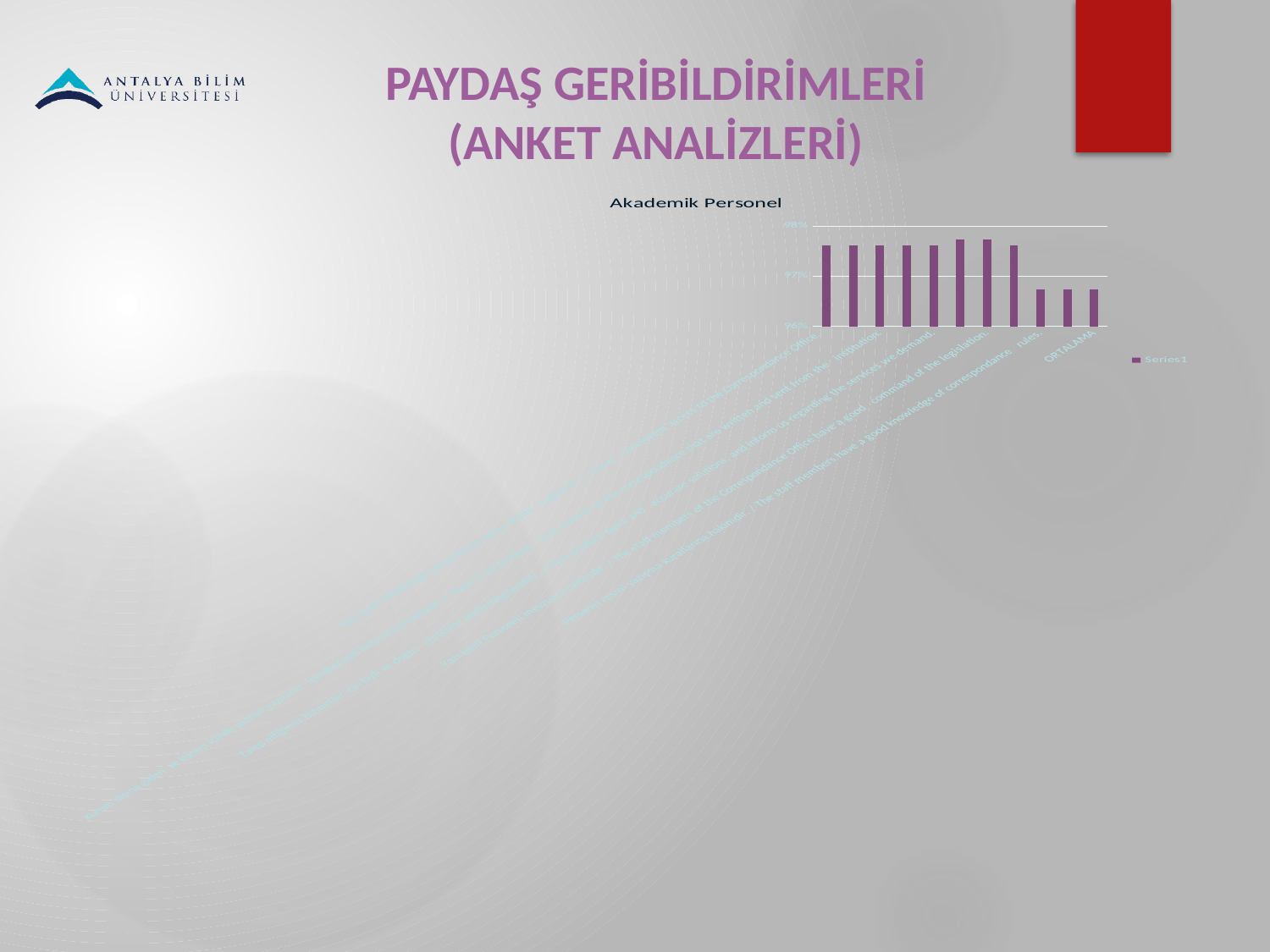
How many series does the legend of the "Akademik Personel" chart list? 1 How many bars are plotted in the "Akademik Personel" chart? 11 In the "Akademik Personel" chart, is the bar for ORTALAMA taller or shorter than the first bar? shorter In the "Akademik Personel" chart, do the values of the last three bars rise or fall compared with the earlier bars? fall What kind of chart is shown under the title "Akademik Personel"? bar chart What is the title of the chart on the slide? Akademik Personel What is the name of the series shown in the legend of the "Akademik Personel" chart? Series1